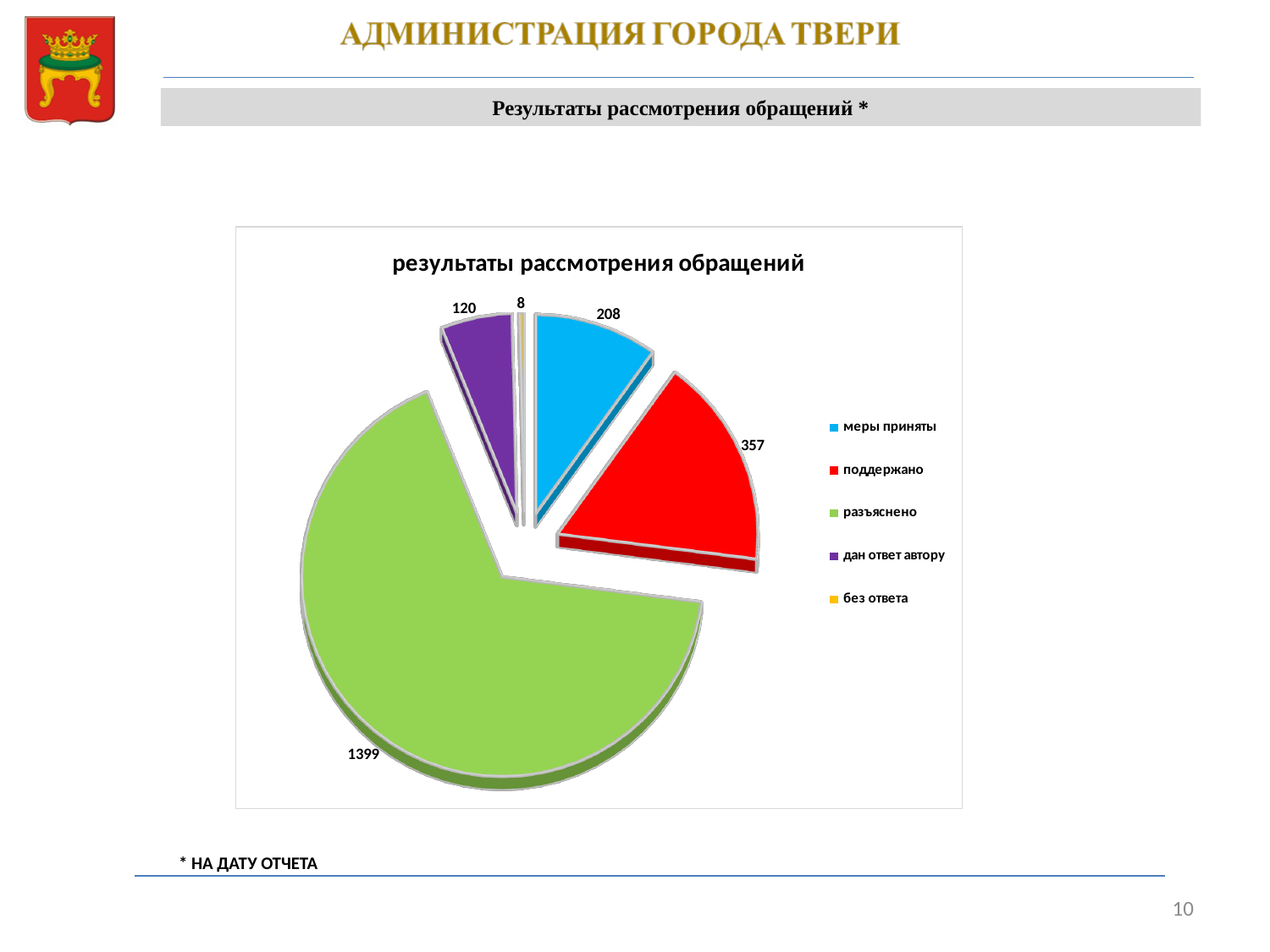
What is the value for "без ответа" in the pie chart? 8 What is the value for "поддержано" in the pie chart? 357 What is the title of the chart? результаты рассмотрения обращений What is the difference between the values for "поддержано" and "меры приняты"? 149 Which is larger: the value for "дан ответ автору" or the value for "меры приняты"? меры приняты What is the value for "меры приняты" in the pie chart? 208 What type of chart is shown on the slide? Pie chart Which category has the smallest slice in the pie chart? без ответа Which category has the largest slice in the pie chart? разъяснено What is the value for "разъяснено" in the pie chart? 1399 What is the value for "дан ответ автору" in the pie chart? 120 How many categories does the pie chart have? 5